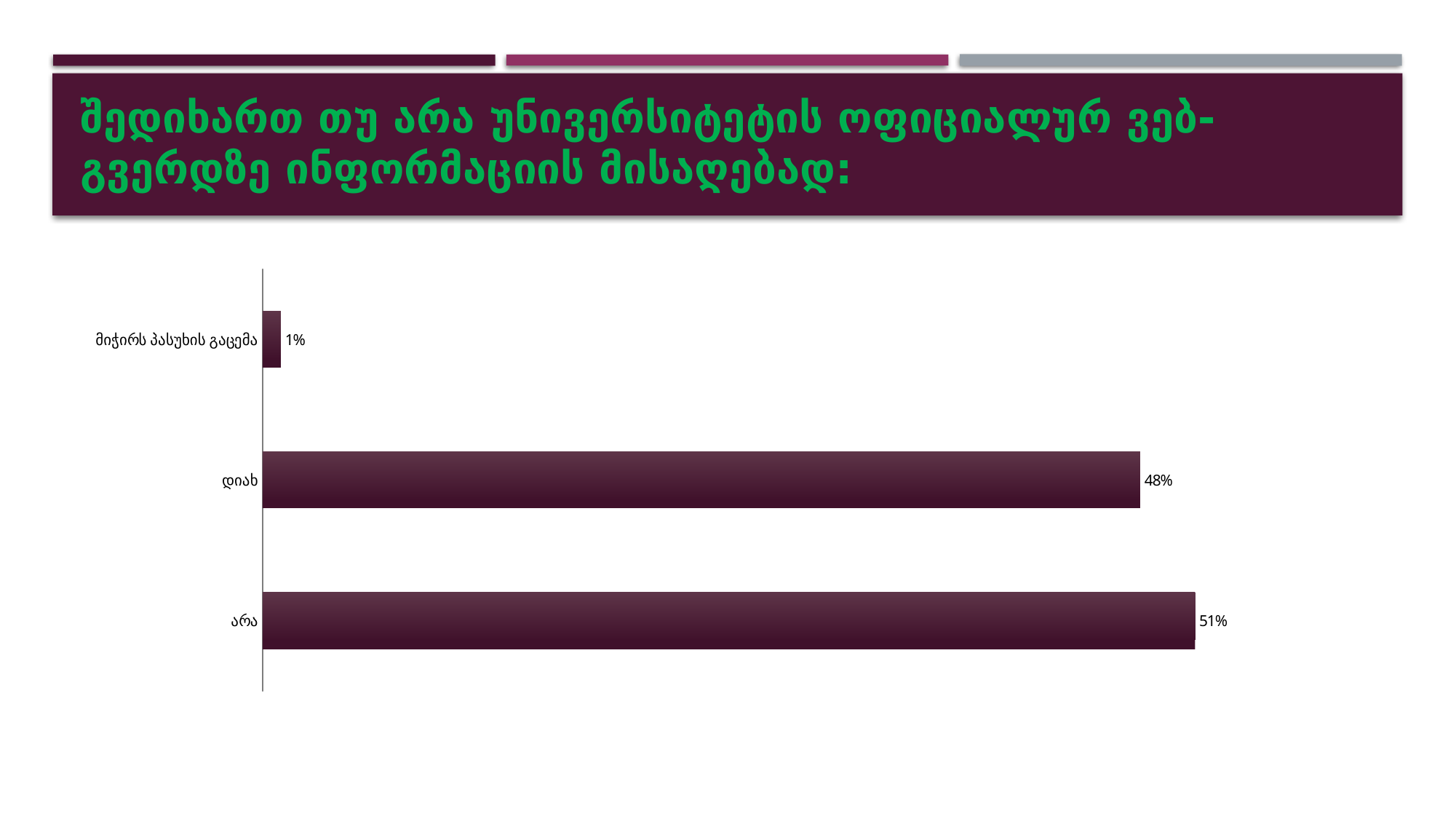
What is the value for "დიახ"? 48% Which is larger, the value for "დიახ" or the value for "მიჭირს პასუხის გაცემა"? დიახ What kind of chart is shown on the slide? Bar chart Are the bars in the chart oriented horizontally or vertically? Horizontally What is the value for "არა"? 51% What is the difference between the values for "არა" and "დიახ"? 3% How many categories are shown in the chart? 3 What is the value for "მიჭირს პასუხის გაცემა"? 1% Which category has the lowest value? მიჭირს პასუხის გაცემა Which category has the highest value? არა What is the title of the slide? შედიხართ თუ არა უნივერსიტეტის ოფიციალურ ვებ-გვერდზე ინფორმაციის მისაღებად: What is the difference between the values for "დიახ" and "მიჭირს პასუხის გაცემა"? 47%